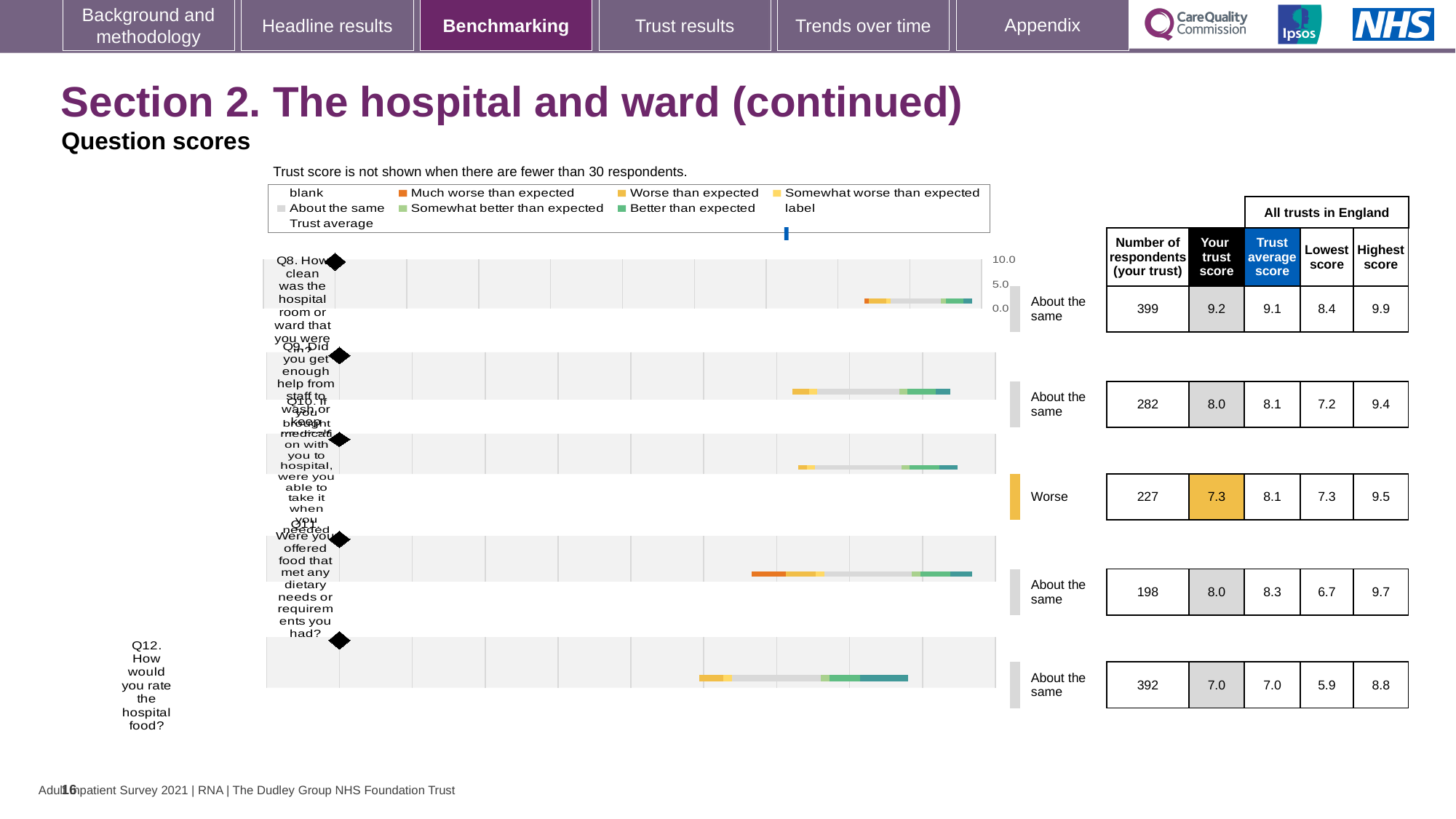
What kind of chart is used to show the question scores? Bar chart How many respondents from your trust answered Q12, how would you rate the hospital food? 392 Which question has the highest 'Your trust score'? Q8 Which question has the lowest 'Your trust score'? Q12 Which is larger for Q8: your trust score or the trust average score? Your trust score Which question is rated 'Worse' rather than 'About the same'? Q10 Is your trust score for Q10 greater or less than 8.0? less What is the difference between the trust average score and your trust score for Q10, about taking medication you brought with you? 0.8 What is the 'Your trust score' for Q8, how clean was the hospital room or ward? 9.2 How many questions are plotted on the chart? 5 What is the highest score across all trusts in England for Q9, did you get enough help from staff to wash or keep yourself clean? 9.4 What is the trust average score for Q11, were you offered food that met any dietary needs or requirements you had? 8.3